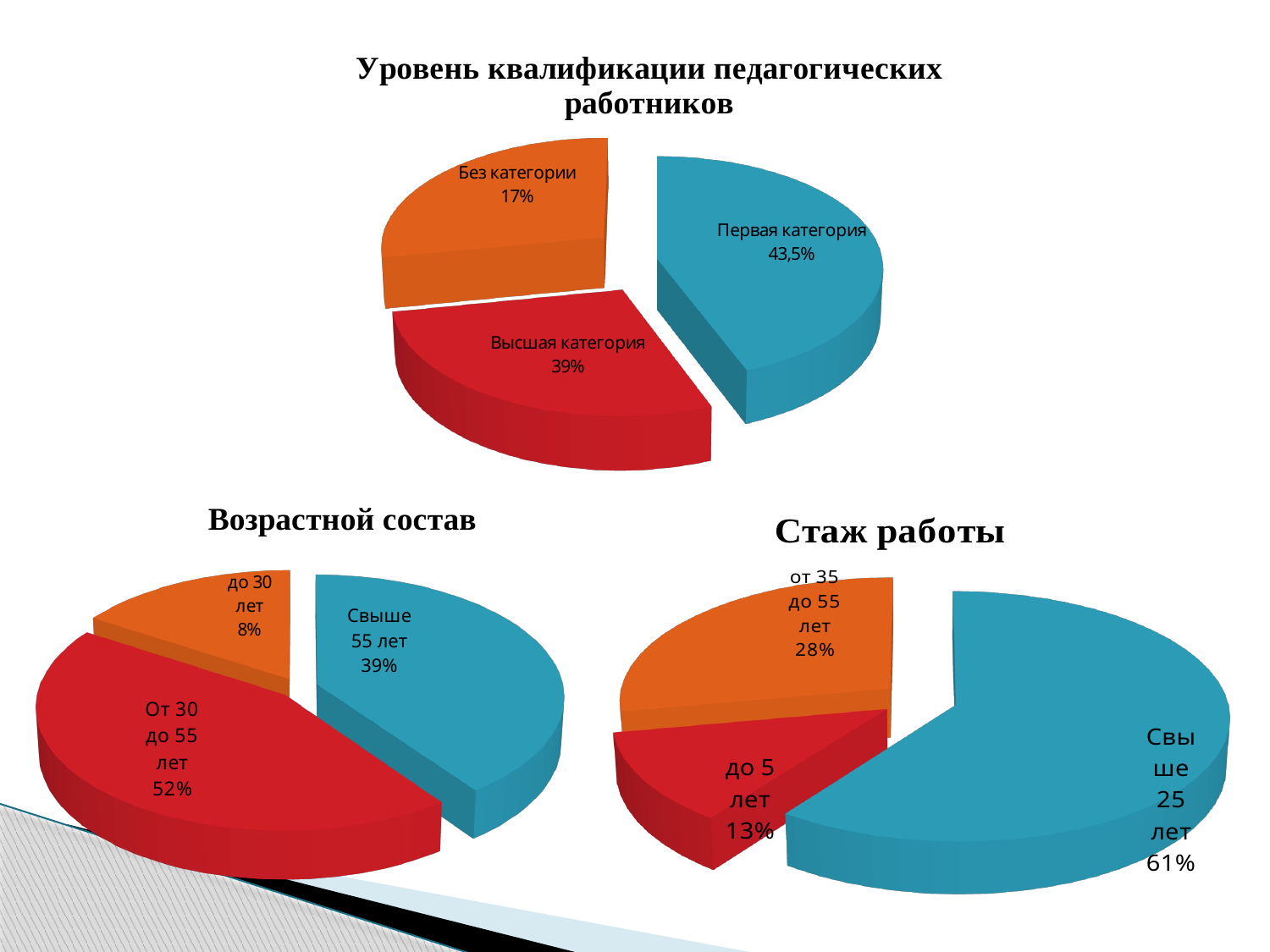
In the chart 'Стаж работы', what is the difference in percentage points between 'Свыше 25 лет' and 'от 35 до 55 лет'? 33 In the chart 'Возрастной состав', which is larger: 'Свыше 55 лет' or 'до 30 лет'? Свыше 55 лет How many pie charts are shown on the slide? 3 In the chart 'Стаж работы', what share is 'Свыше 25 лет'? 61% In the chart 'Возрастной состав', what share is 'От 30 до 55 лет'? 52% What type of chart is 'Возрастной состав'? Pie chart In the chart 'Уровень квалификации педагогических работников', which category has the smallest share? Без категории In the chart 'Стаж работы', which category has the smallest share? до 5 лет In the chart 'Возрастной состав', which category has the largest share? От 30 до 55 лет In the chart 'Уровень квалификации педагогических работников', what is the difference in percentage points between 'Высшая категория' and 'Без категории'? 22 In the chart 'Уровень квалификации педагогических работников', what share is 'Первая категория'? 43,5% How many slices does the chart 'Уровень квалификации педагогических работников' have? 3